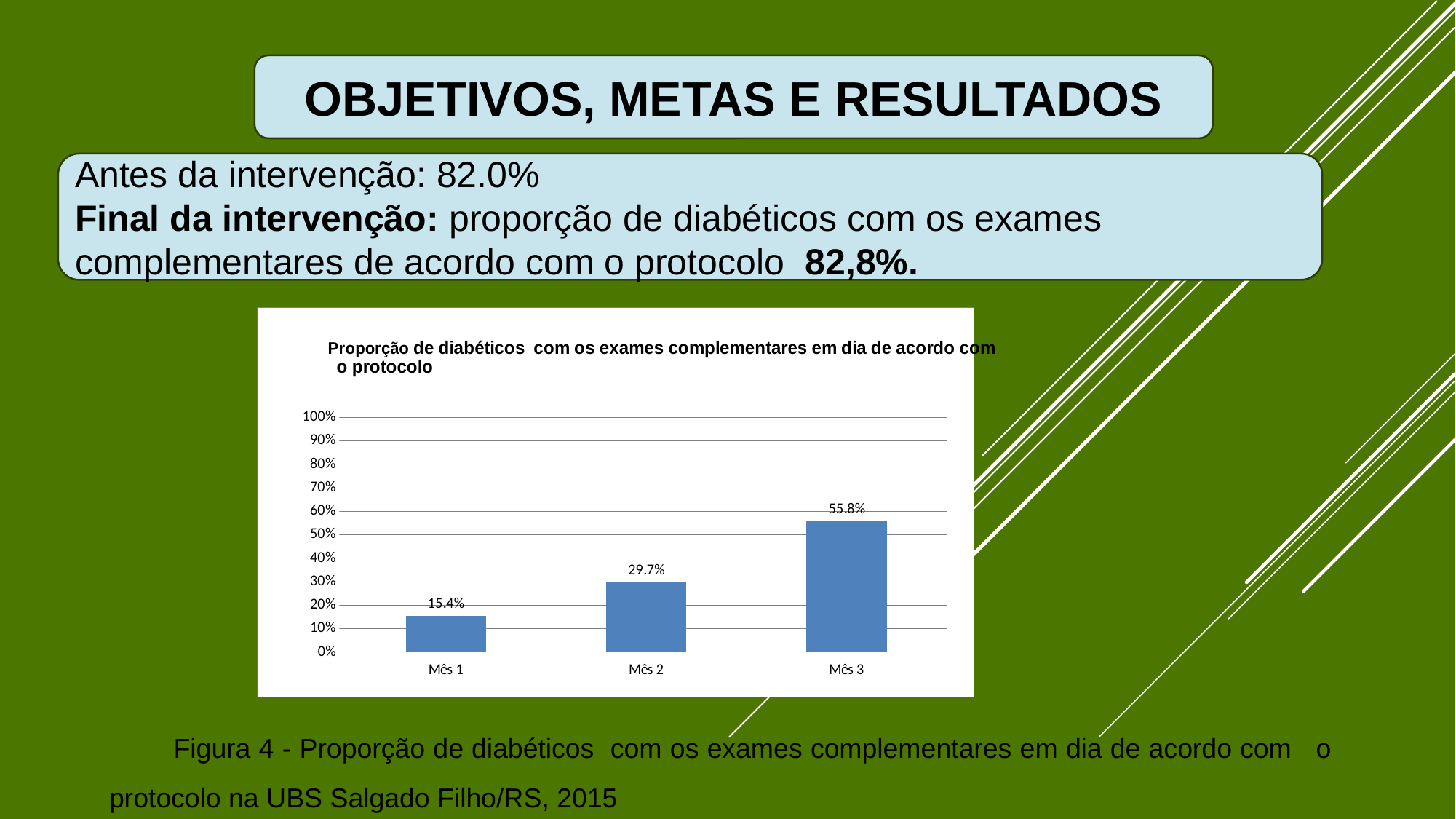
What is the difference between the values for Mês 2 and Mês 1? 14.3% Which month has the lowest value? Mês 1 Do the values rise or fall from Mês 1 to Mês 3? rise Which month has the highest value? Mês 3 What is the value for Mês 3? 55.8% What is the difference between the values for Mês 3 and Mês 2? 26.1% What is the value for Mês 2? 29.7% What is the value for Mês 1? 15.4% What kind of chart is shown on the slide? bar chart Is the value for Mês 3 greater or less than 50%? greater How many months are shown on the x axis? 3 Which is larger, the value for Mês 1 or the value for Mês 2? Mês 2